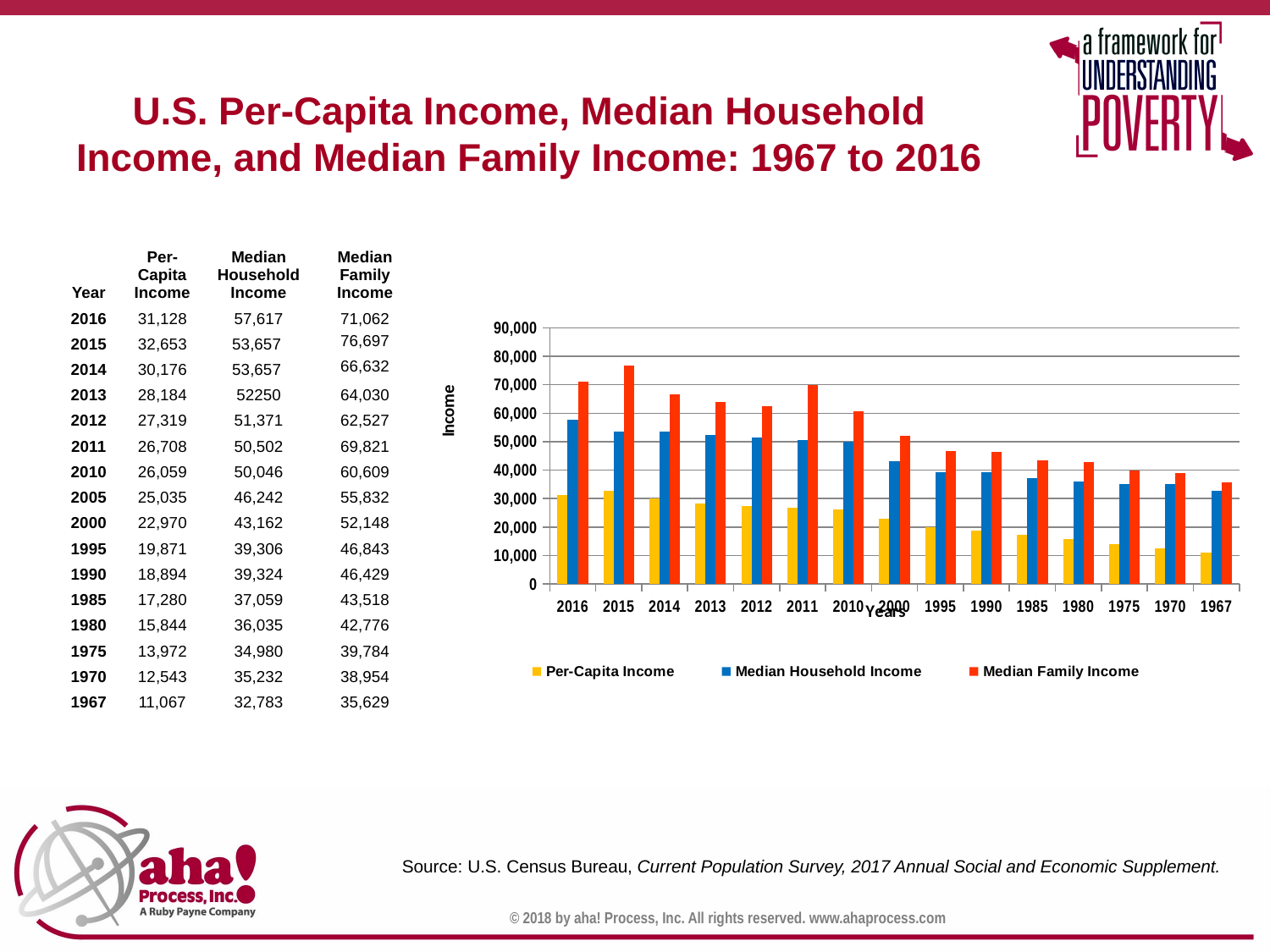
Moving left to right along the x axis from 2016 to 1967, do the Median Household Income bars generally rise or fall? fall What is the difference between Median Family Income in 2016 and in 1967? 35,433 What is the Median Household Income for 2000? 43,162 Is the Per-Capita Income for 1967 greater or less than 20,000? less Is the Median Family Income for 2015 greater or less than 70,000? greater Which year has the larger Median Household Income, 2016 or 2015? 2016 What is the Per-Capita Income for 2016? 31,128 What kind of chart is shown on the slide? Bar chart In which year is Per-Capita Income lowest? 1967 In which year is Median Family Income highest? 2015 How many series does the chart's legend list? 3 How many years are shown along the x axis of the chart? 15